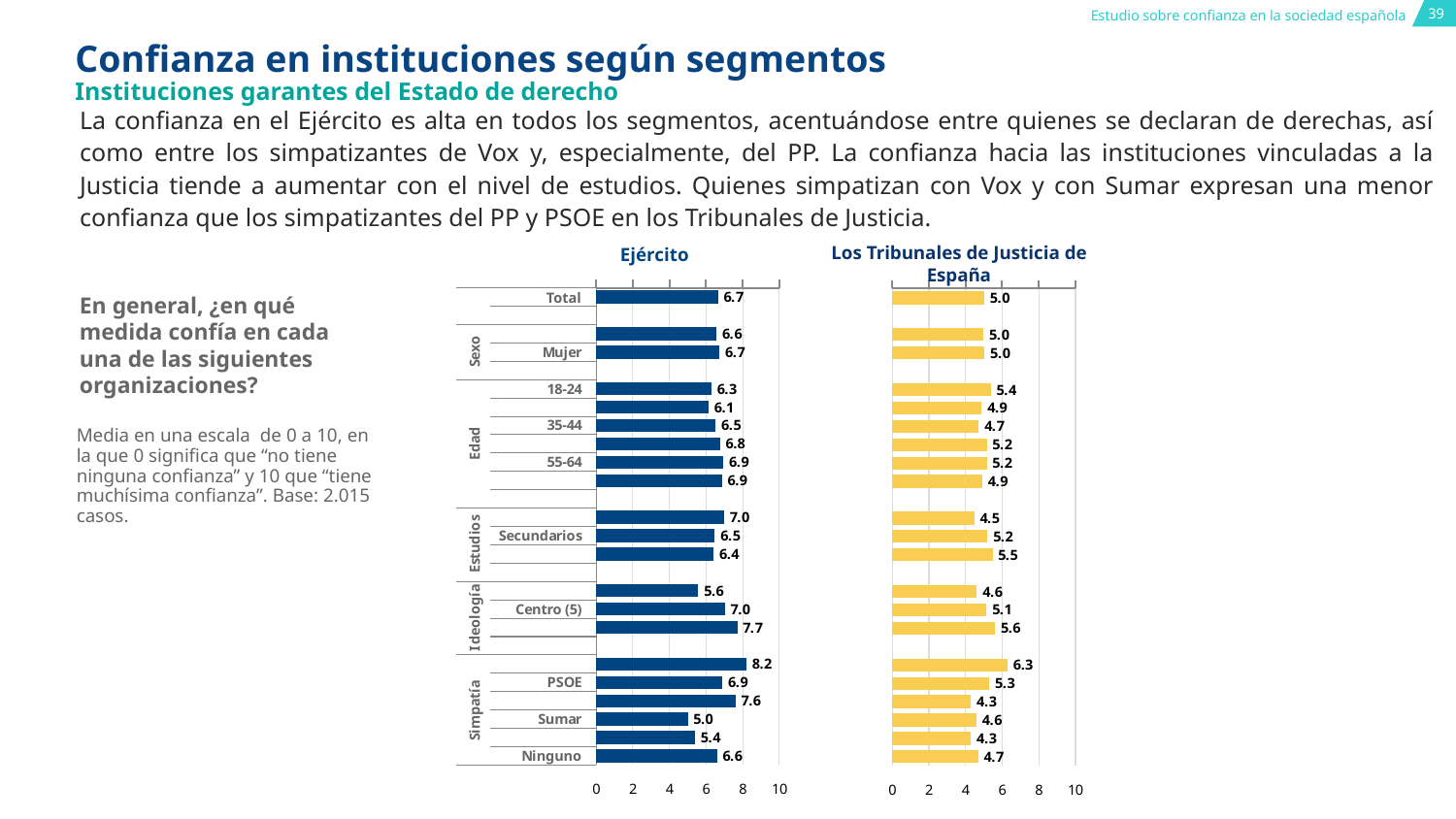
In the Los Tribunales de Justicia de España chart, which is larger, the value for Secundarios or the value for 35-44? Secundarios In the Ejército chart, what is the value for Total? 6.7 In the Los Tribunales de Justicia de España chart, what is the value for Sumar? 4.6 In the Ejército chart, what is the difference between the values for PSOE and Sumar? 1.9 What is the title of the chart on the right? Los Tribunales de Justicia de España In the Los Tribunales de Justicia de España chart, what is the difference between the values for PSOE and Ninguno? 0.6 In the Ejército chart, what is the value for Sumar? 5.0 In the Ejército chart, which is larger, the value for 55-64 or the value for 18-24? 55-64 What kind of chart is the Ejército chart? Bar chart In the Los Tribunales de Justicia de España chart, what is the value for 18-24? 5.4 In the Ejército chart, what is the value for Centro (5)? 7.0 What is the highest value shown in the Ejército chart? 8.2